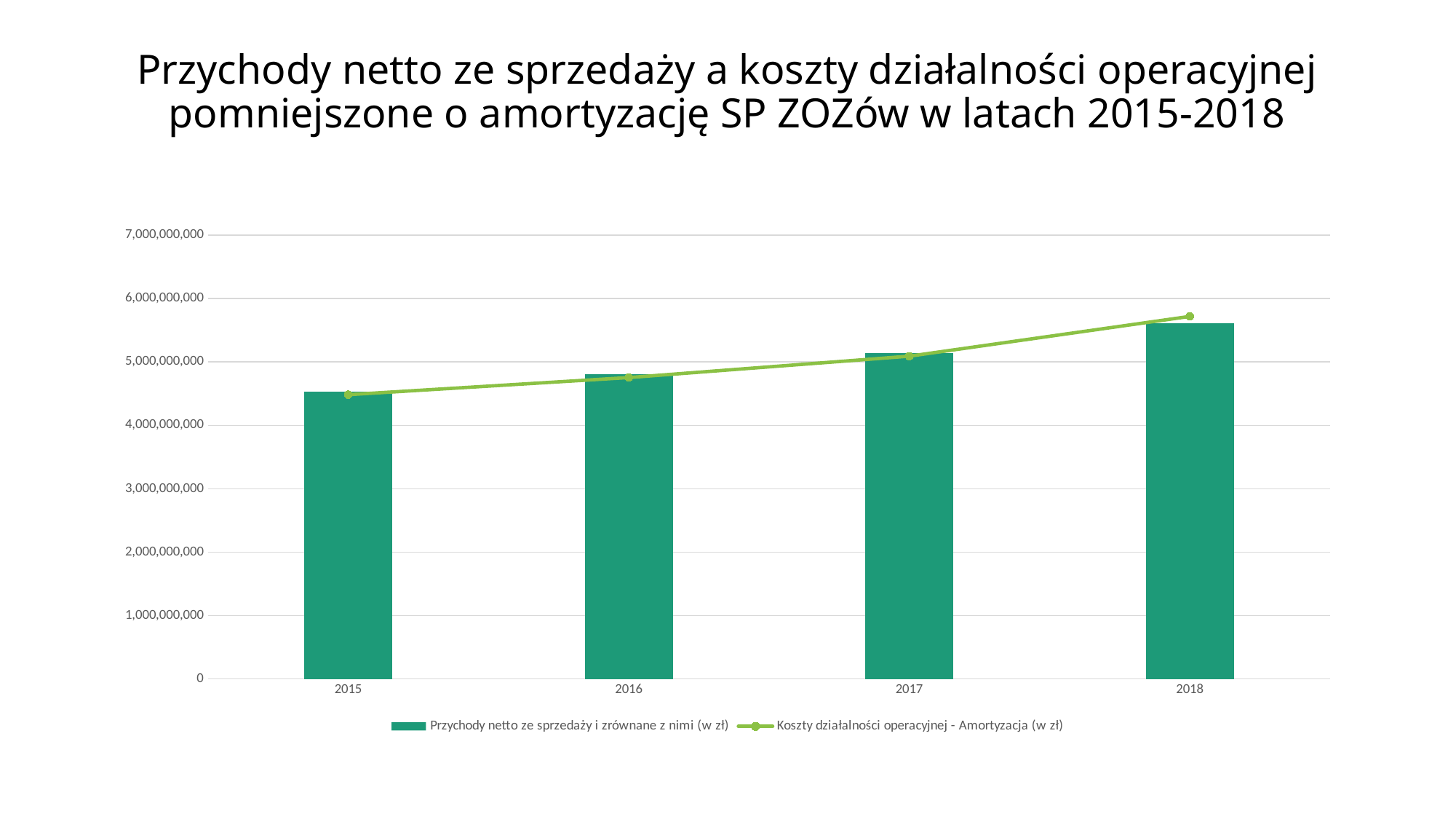
Which year has the lowest bar for 'Przychody netto ze sprzedaży i zrównane z nimi (w zł)'? 2015 Is the value for 'Koszty działalności operacyjnej - Amortyzacja (w zł)' in 2018 greater or less than 5,000,000,000? greater What kind of chart is shown on the slide? A bar chart combined with a line chart Is the value for 'Przychody netto ze sprzedaży i zrównane z nimi (w zł)' in 2016 greater or less than 5,000,000,000? less Which series is drawn as a line in the chart? Koszty działalności operacyjnej - Amortyzacja (w zł) How many years are shown on the x axis of the chart? 4 Which is larger: the 'Koszty działalności operacyjnej - Amortyzacja (w zł)' value in 2015 or in 2018? 2018 How many series does the chart legend list? 2 Which year has the highest bar for 'Przychody netto ze sprzedaży i zrównane z nimi (w zł)'? 2018 Do the values of 'Przychody netto ze sprzedaży i zrównane z nimi (w zł)' rise or fall from 2015 to 2018? Rise Is the value for 'Przychody netto ze sprzedaży i zrównane z nimi (w zł)' in 2018 greater or less than 6,000,000,000? less